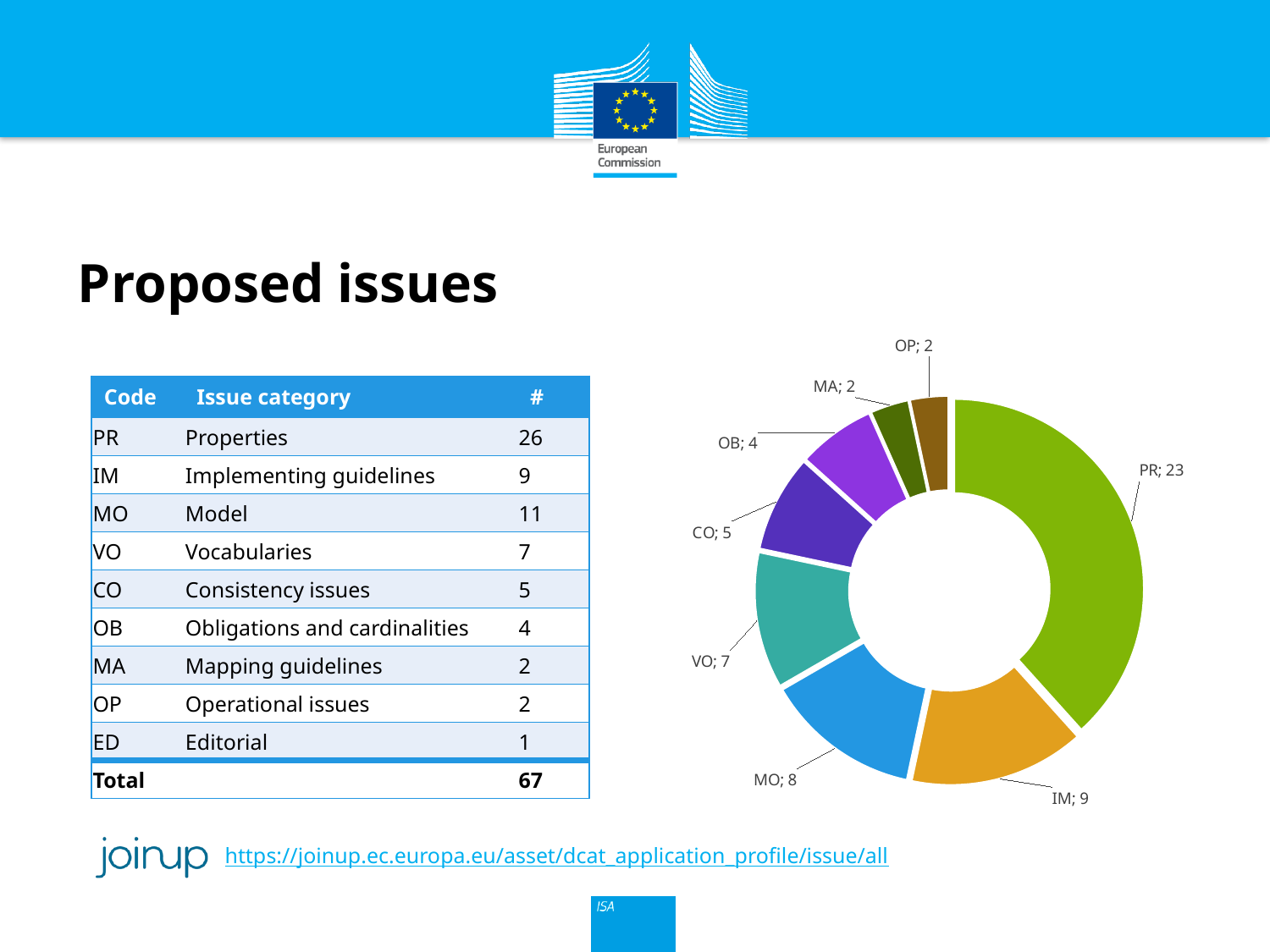
In the doughnut chart, what value is shown for OB? 4 In the doughnut chart, which is larger, the value for MO or the value for VO? MO In the doughnut chart, what is the difference between the values for PR and IM? 14 In the doughnut chart, what value is shown for VO? 7 In the doughnut chart, what value is shown for PR? 23 In the doughnut chart, what value is shown for IM? 9 What kind of chart is shown on the right of the slide? Doughnut (pie) chart What is the sum of all the values labelled on the doughnut chart? 60 Which category has the largest slice in the doughnut chart? PR In the doughnut chart, what value is shown for CO? 5 How many slices does the doughnut chart have? 8 In the doughnut chart, what value is shown for MO? 8